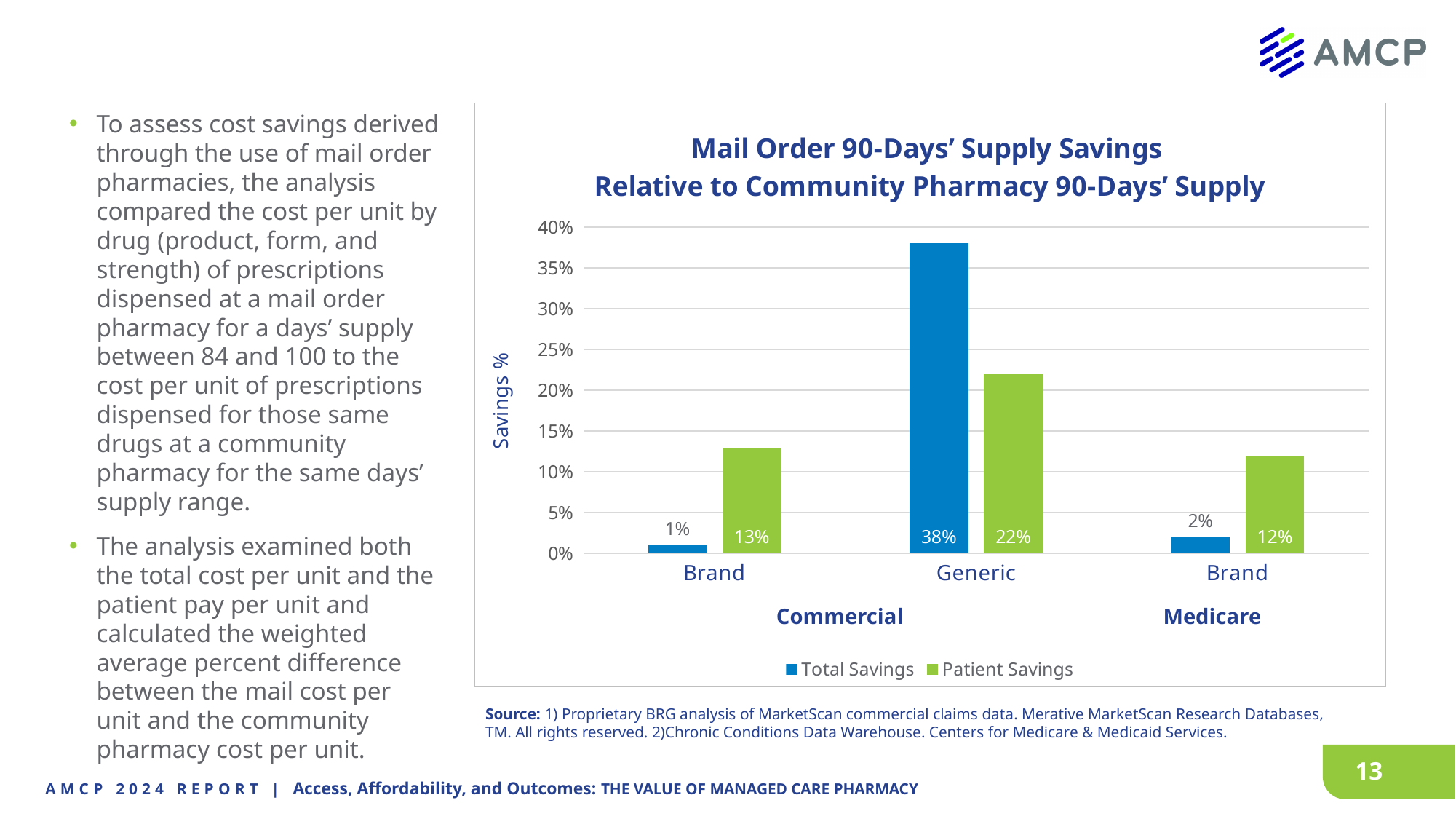
Which category has the highest Total Savings? Generic (Commercial) How many series does the legend list? 2 What is the difference between Total Savings and Patient Savings for Commercial Generic? 16% What is the Total Savings value for Commercial Generic? 38% What kind of chart is shown on the slide? Bar chart What is the label of the y axis? Savings % What is the Patient Savings value for Commercial Brand? 13% Is the Total Savings value for Commercial Generic greater or less than 35%? greater Which is larger for Commercial Brand: Total Savings or Patient Savings? Patient Savings What is the Patient Savings value for Medicare Brand? 12% What is the Total Savings value for Medicare Brand? 2% Which category has the lowest Total Savings? Brand (Commercial)